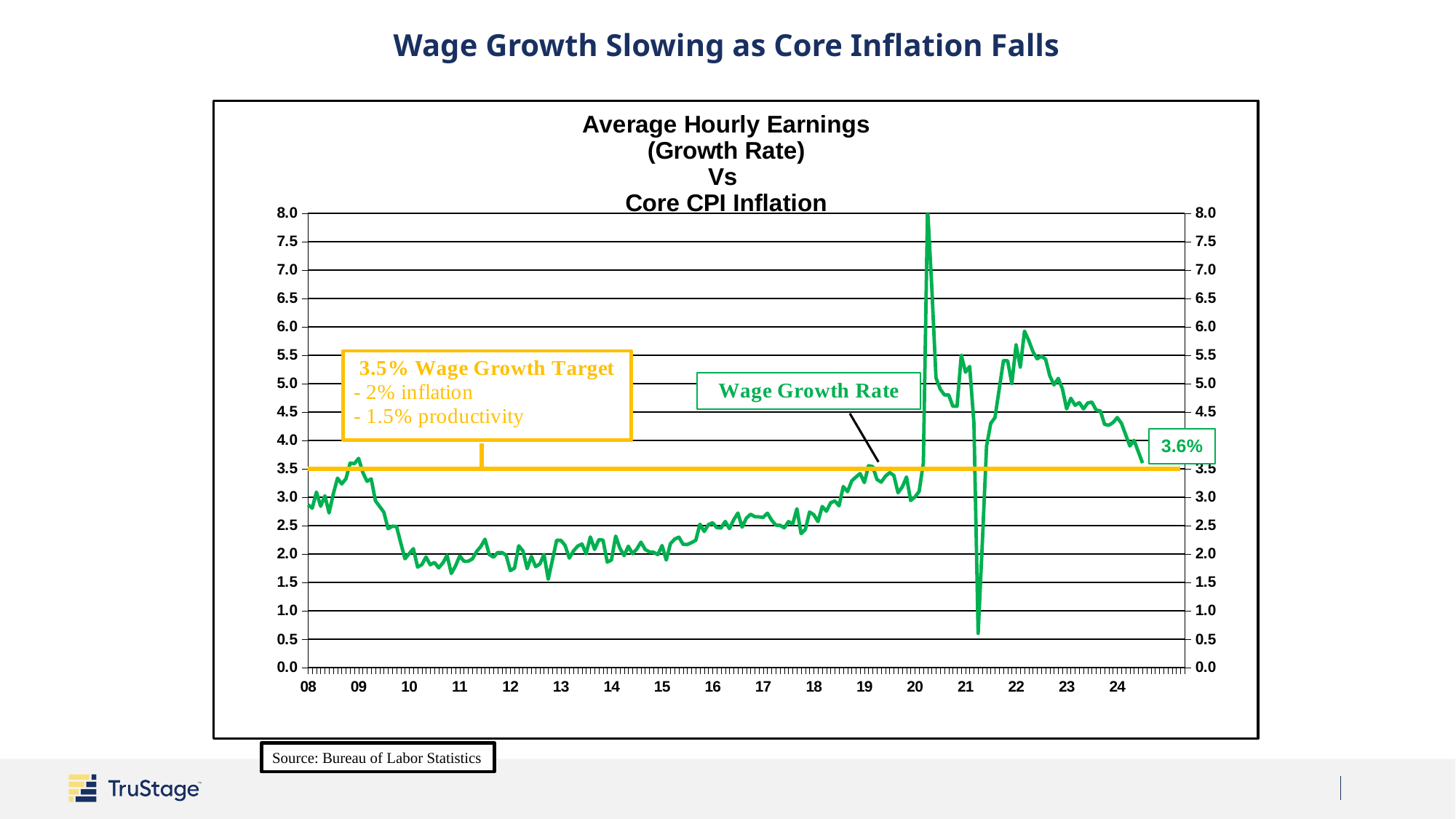
Does the wage growth rate rise or fall from 2022 to 2024? Fall Is the peak wage growth rate in 2022 greater or less than 5.0? greater By how much does the latest wage growth rate (3.6%) exceed the 3.5% wage growth target? 0.1% In which year does the wage growth rate fall to its lowest point? 2021 What is the source cited for the chart data? Bureau of Labor Statistics In which year does the wage growth rate reach its highest spike? 2020 Is the wage growth rate in 2010 greater or less than 2.5? less What two components make up the 3.5% wage growth target according to the annotation box? 2% inflation and 1.5% productivity Which year has a higher wage growth rate, 2013 or 2022? 2022 What is the most recent wage growth rate value labeled at the end of the green line? 3.6% What wage growth target is marked by the yellow horizontal line? 3.5% What kind of chart is shown on the slide? Line chart